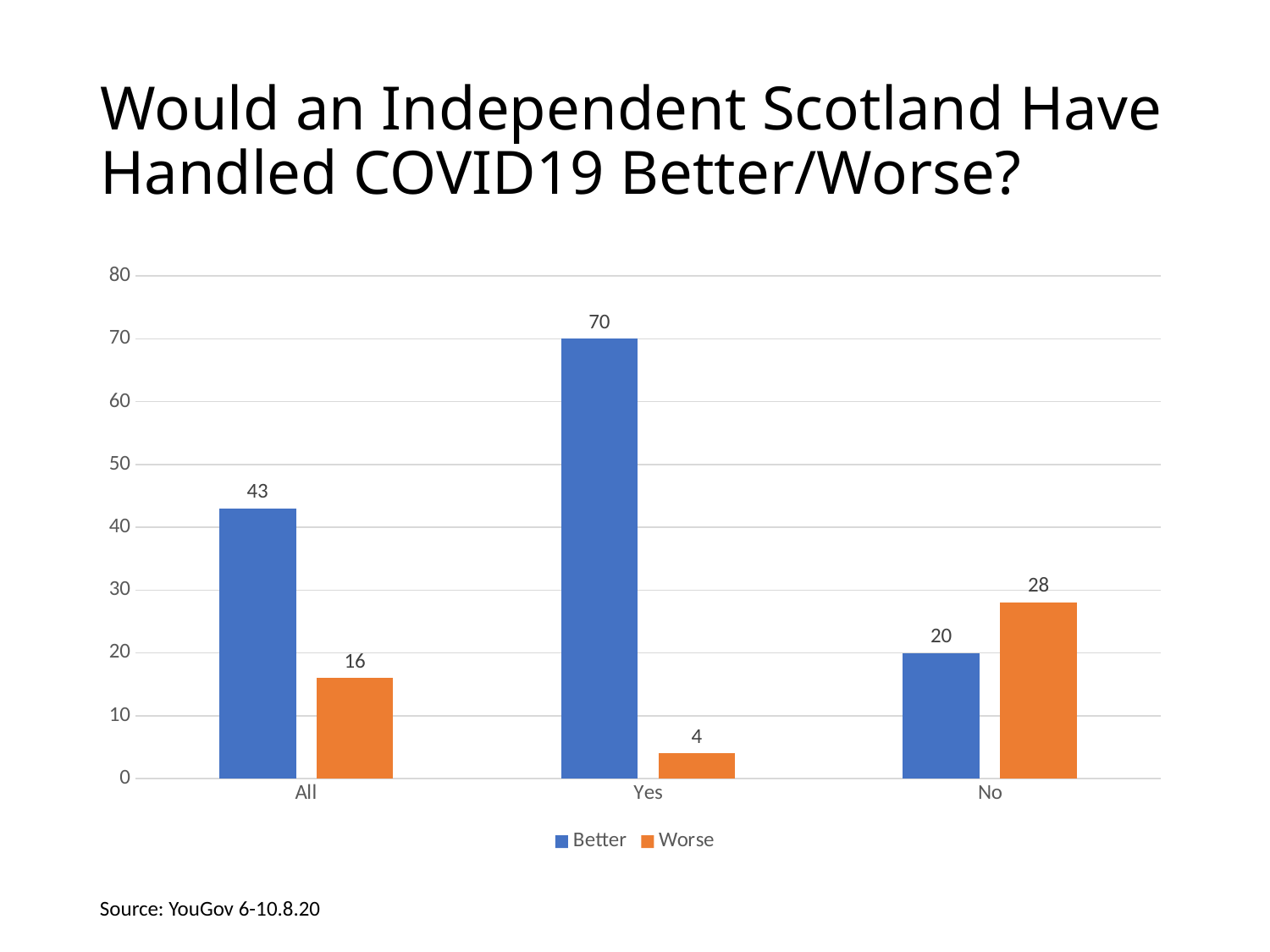
How many series does the legend list? 2 What is the difference between Better and Worse in the Yes category? 66 Which category has the lowest value for Worse? Yes What kind of chart is shown on the slide? Bar chart Which category has the highest value for Better? Yes What is the difference between Better and Worse in the All category? 27 What is the value for Worse in the Yes category? 4 Is the value for Better in the No category greater or less than 30? less What is the value for Worse in the No category? 28 How many categories are shown on the x axis? 3 What is the value for Better in the All category? 43 In the No category, which is larger, Better or Worse? Worse